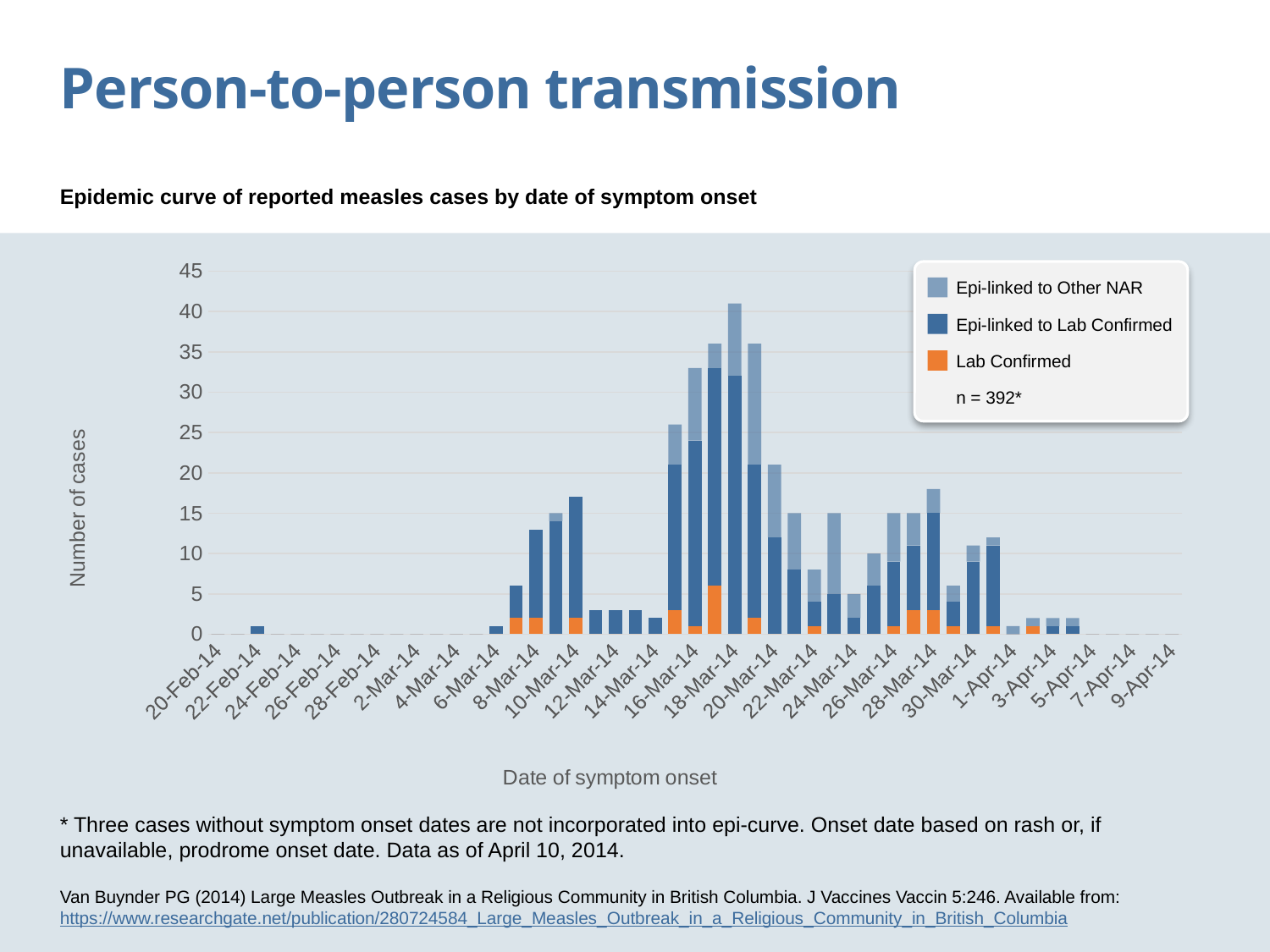
What is the highest value shown on the y axis? 45 Is the tallest bar in April greater or less than 5? less Is the tallest bar in the chart greater or less than 45? less How many series does the legend list? 3 What total number of cases (n) is stated in the legend box? n = 392* Is the only bar in February greater or less than 5? less Which series is shown in orange in the legend? Lab Confirmed How do the number of cases change along the x axis from early March to early April? They rise to a peak in mid-March and then fall What kind of chart is shown on the slide? Stacked bar chart How many date labels are shown on the x axis? 25